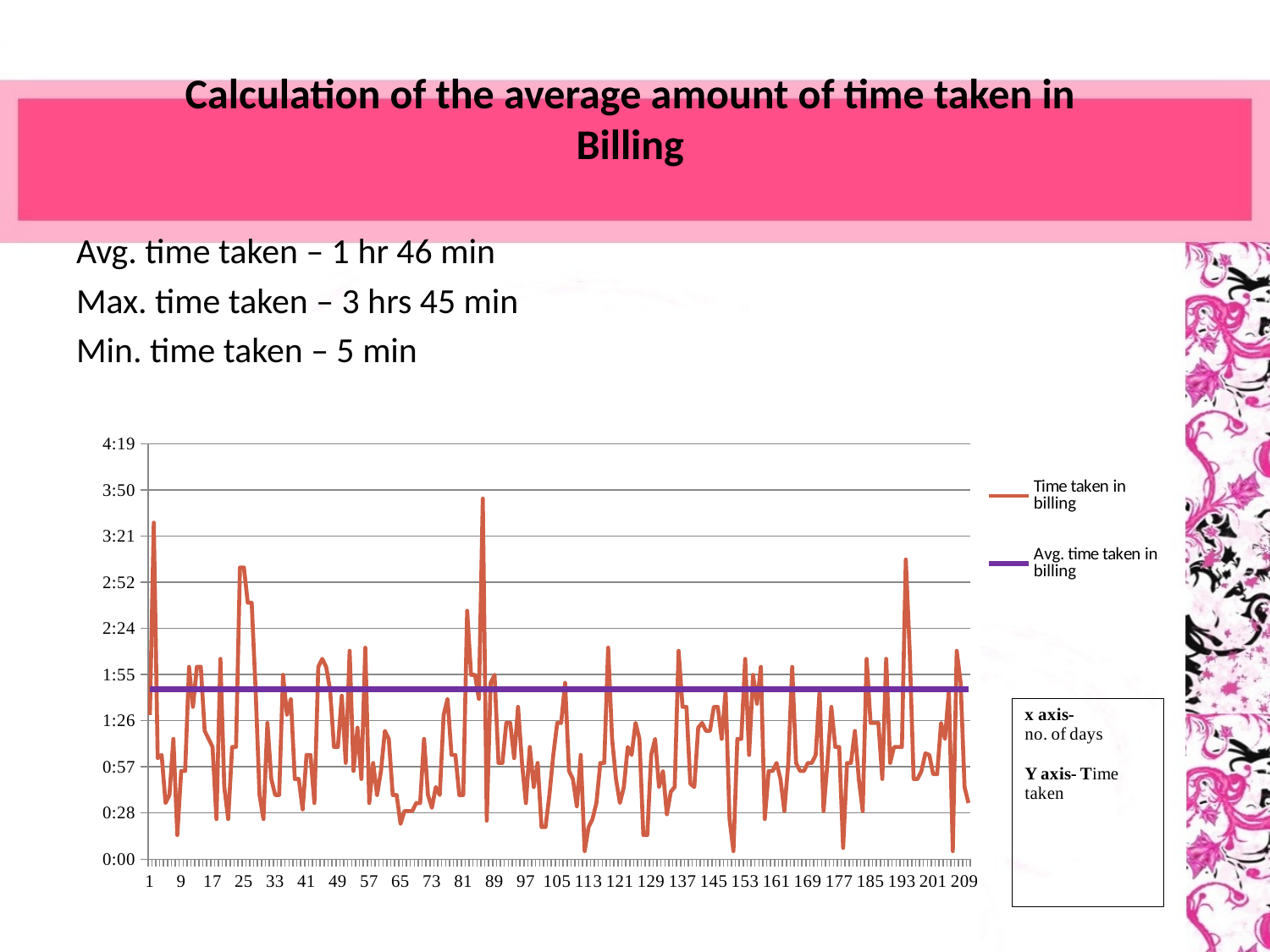
Is the highest peak of the 'Time taken in billing' series greater or less than 3:50? less What does the x axis of the chart represent, according to the note beside it? No. of days What is the maximum time taken in billing, as stated on the slide? 3 hrs 45 min How many series does the chart legend list? 2 Is the 'Avg. time taken in billing' line greater or less than 1:26 on the y axis? greater Is the highest peak of the 'Time taken in billing' series greater or less than 3:21? greater What is the highest tick label shown on the chart's y axis? 4:19 What are the two series named in the chart legend? Time taken in billing; Avg. time taken in billing What is the average time taken in billing, as stated on the slide? 1 hr 46 min What kind of chart is shown on the slide? Line chart What is the minimum time taken in billing, as stated on the slide? 5 min